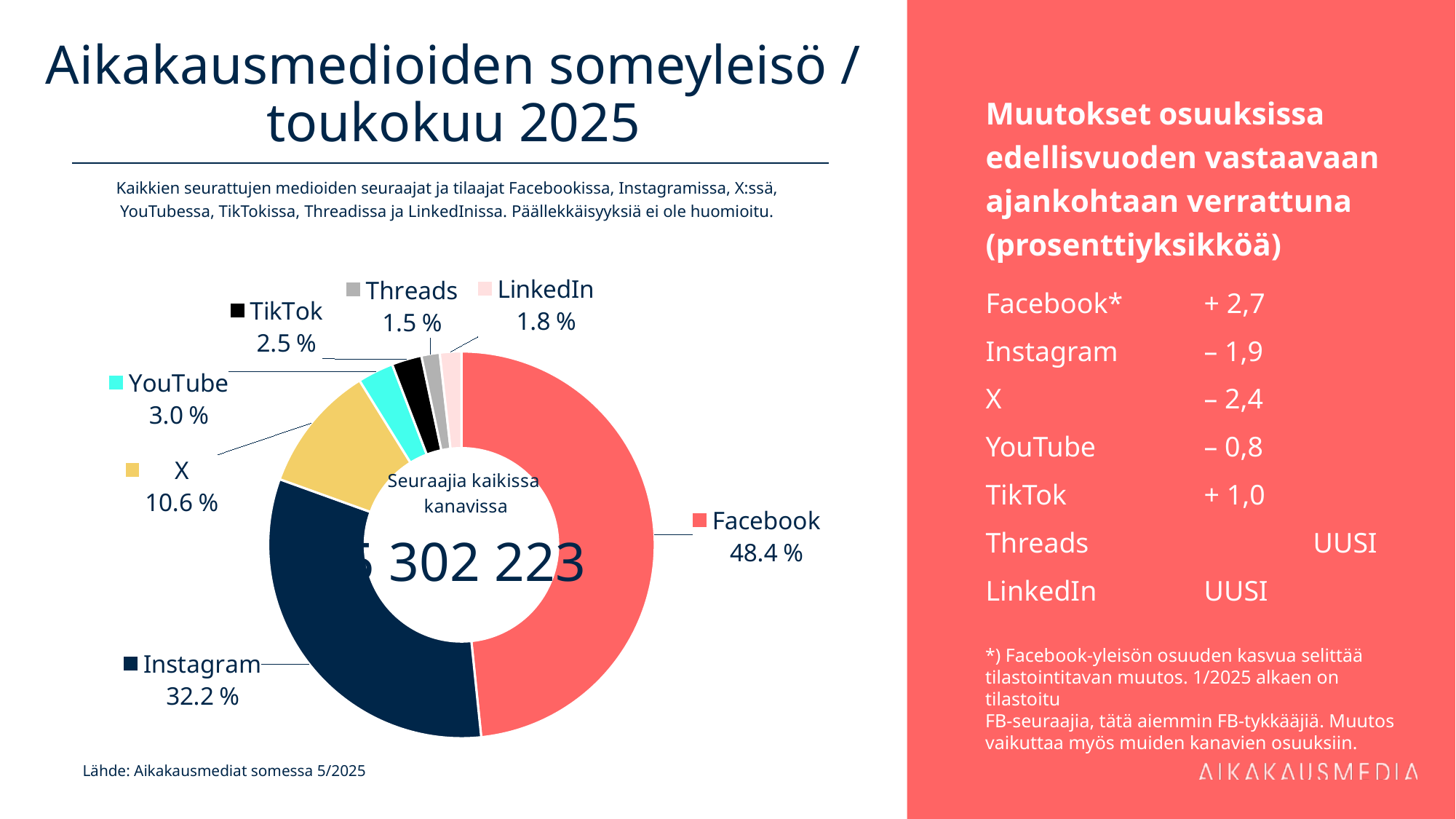
What kind of chart is shown on the slide? pie chart (donut) Which channel has the largest share of the audience? Facebook What is the difference in percentage points between LinkedIn's and Threads' shares? 0.3 Which channel has the smallest share of the audience? Threads What share of the audience does TikTok have? 2.5 % How many channels (slices) are shown in the chart? 7 What share of the audience does Instagram have? 32.2 % What is the difference in percentage points between Facebook's and Instagram's shares? 16.2 Which has a larger share, YouTube or TikTok? YouTube What colour is the Facebook slice in the chart? red (coral) What share of the audience does X have? 10.6 % What share of the audience does Facebook have? 48.4 %